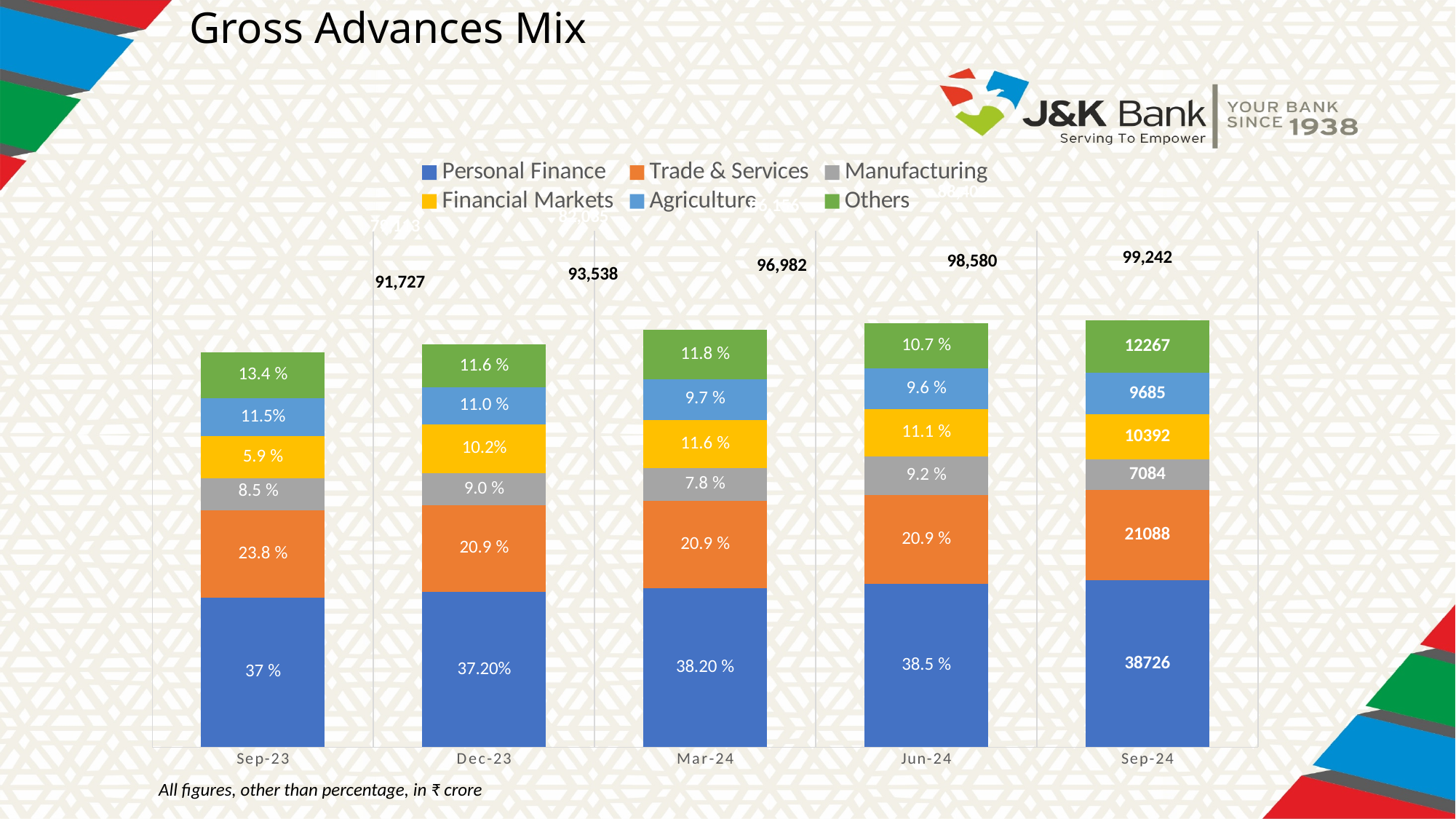
What is the total gross advances figure shown above the Sep-24 bar? 99,242 Which period has the highest total gross advances? Sep-24 Do the total gross advances rise or fall from Sep-23 to Sep-24? rise Which is larger, the Trade & Services share in Sep-23 or in Dec-23? Sep-23 What is the Trade & Services share for Sep-23? 23.8 % What is the Manufacturing share for Jun-24? 9.2 % What is the difference between the total for Sep-24 and the total for Sep-23? 7,515 What is the Personal Finance share for Sep-23? 37 % What is the Agriculture share for Dec-23? 11.0 % How many series does the legend list? 6 What is the Others value for Sep-24? 12267 Which period has the lowest total gross advances? Sep-23